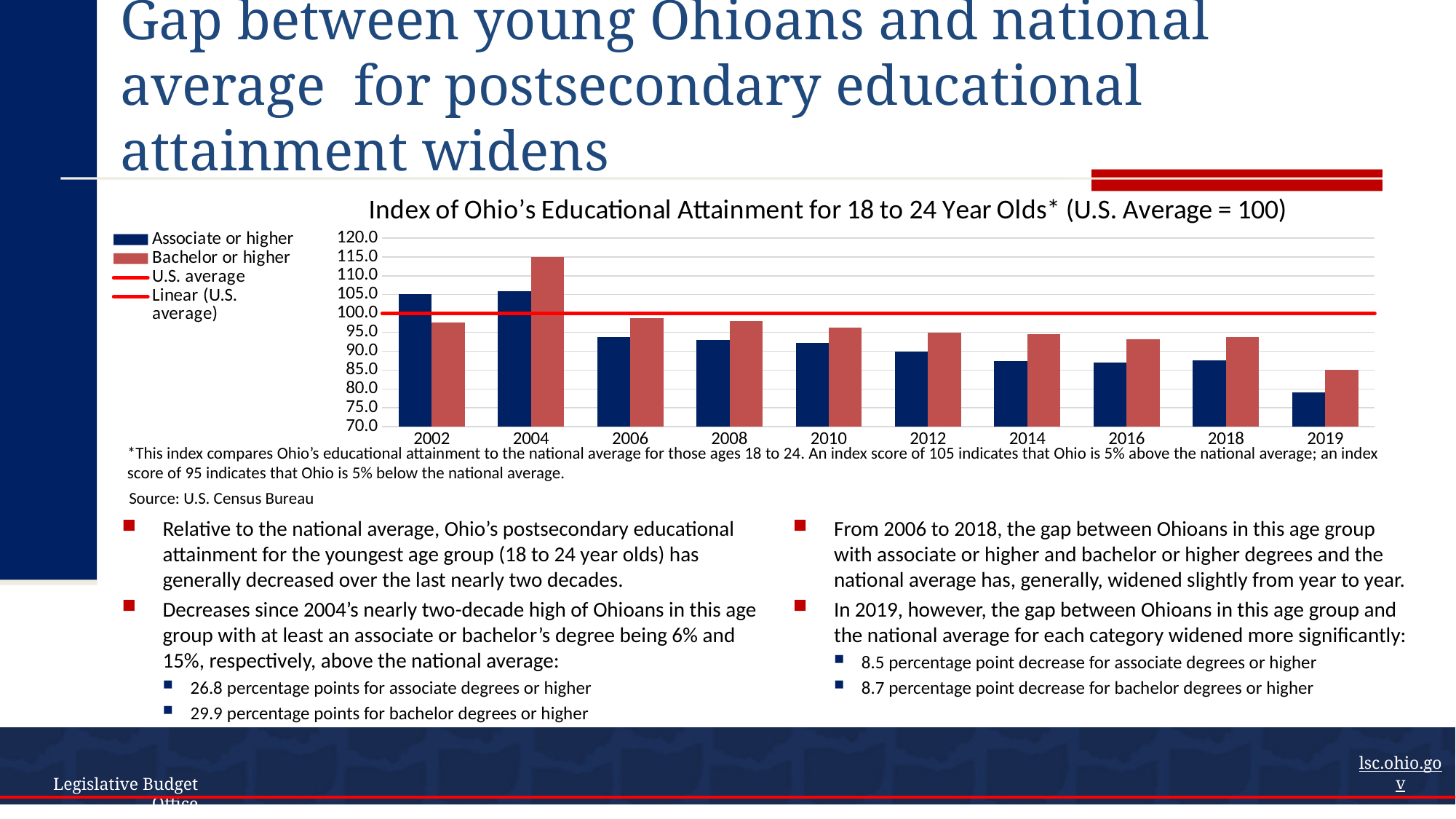
In which year is the Bachelor or higher index the highest? 2004 Is the Bachelor or higher value for 2016 greater or less than 90.0? greater What kind of chart is shown on the slide? Bar chart Is the Bachelor or higher value for 2004 greater or less than 110.0? greater In 2010, which is larger: the Associate or higher index or the Bachelor or higher index? Bachelor or higher In 2002, which is larger: the Associate or higher index or the Bachelor or higher index? Associate or higher What is the title of the chart? Index of Ohio's Educational Attainment for 18 to 24 Year Olds* (U.S. Average = 100) How many years are shown along the x axis of the chart? 10 In which year is the Associate or higher index the lowest? 2019 Does the Associate or higher index generally rise or fall from 2004 to 2019? fall Is the Associate or higher value for 2019 greater or less than 80.0? less How many entries does the chart's legend list? 4